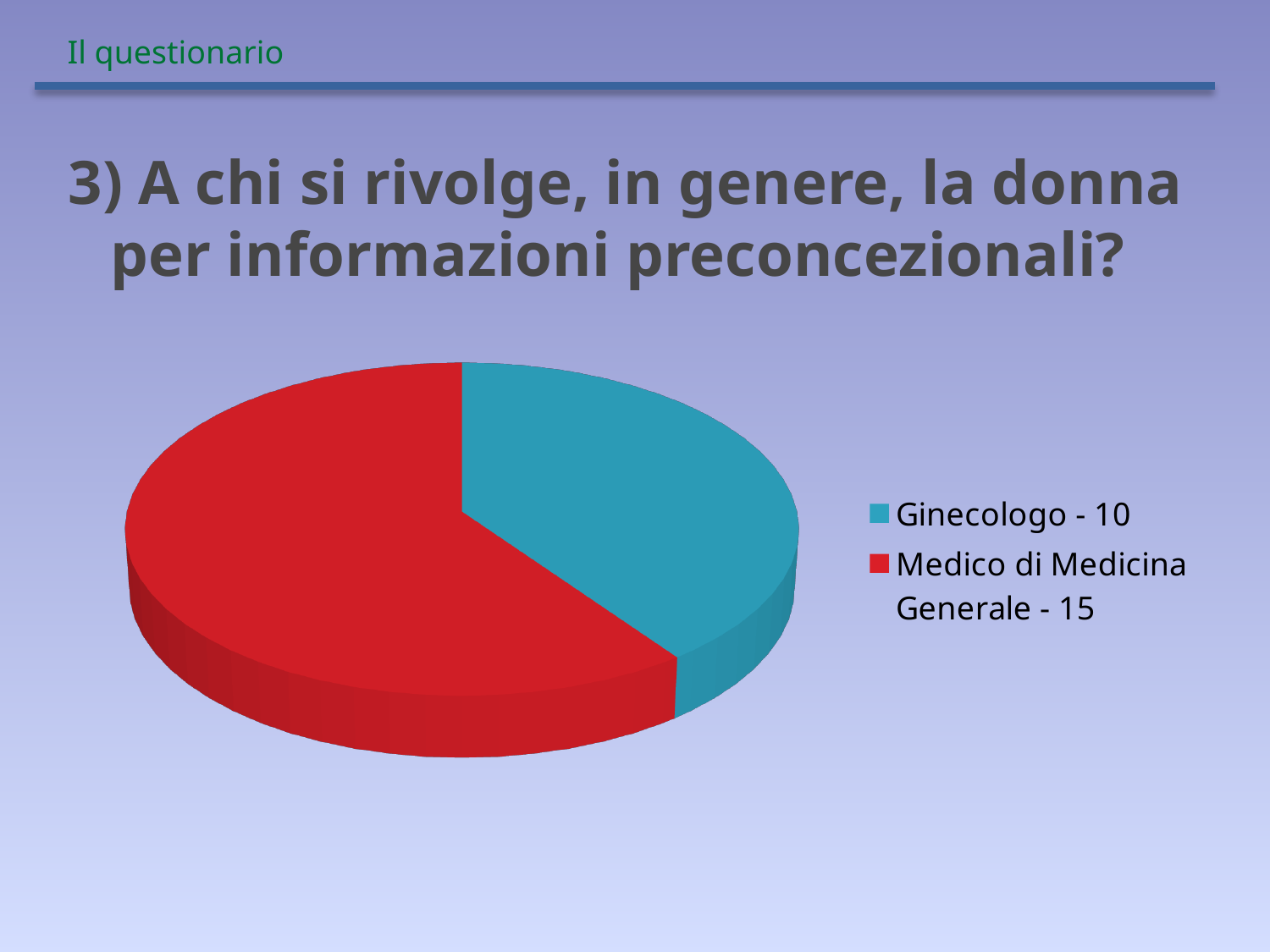
Which category has the largest slice of the pie? Medico di Medicina Generale Which category has the smallest slice of the pie? Ginecologo What share of the pie does the Medico di Medicina Generale slice represent? 60% What is the difference between the values for Medico di Medicina Generale and Ginecologo? 5 What is the total of the two values shown in the legend? 25 Which is larger, the value for Ginecologo or for Medico di Medicina Generale? Medico di Medicina Generale What value is given for Medico di Medicina Generale in the legend? 15 What value is given for Ginecologo in the legend? 10 What colour is the Ginecologo slice? blue What kind of chart is shown on the slide? pie chart What is the title of the chart? 3) A chi si rivolge, in genere, la donna per informazioni preconcezionali? How many slices does the pie chart have? 2